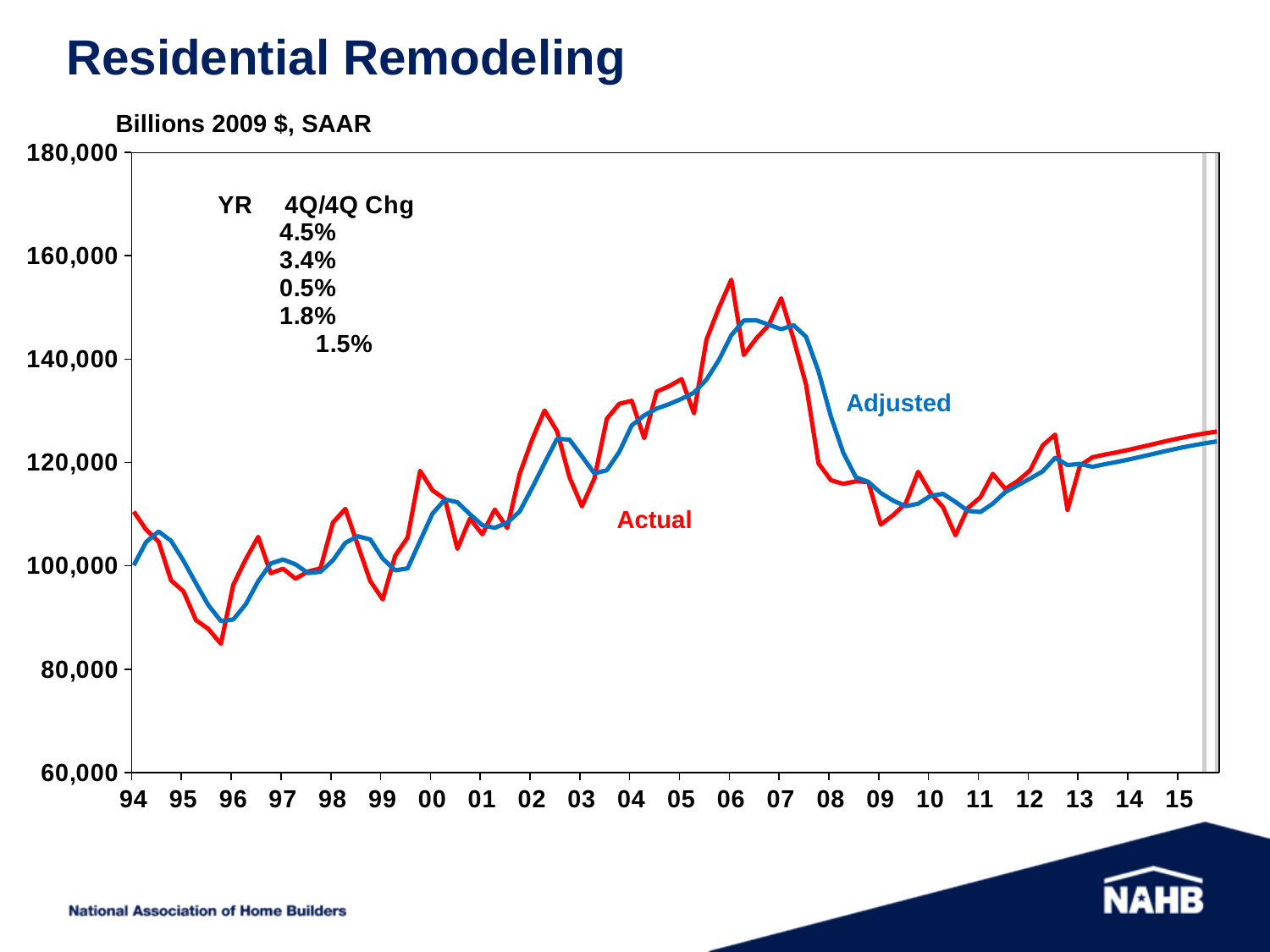
In which year does the Actual series reach its lowest value? 95 At the 06 peak, which series is higher, Actual or Adjusted? Actual Is the Adjusted value at 09 greater or less than 120,000? less Is the lowest value of the Actual series around 96 greater or less than 100,000? less What colour is the Actual line? red How many data series are plotted on the chart? 2 Does the Adjusted series rise or fall between 07 and 09? fall Is the peak value of the Actual series around 06 greater or less than 140,000? greater What kind of chart is shown on the slide? line chart In which year does the Actual series reach its highest value? 06 What unit label is shown above the y axis? Billions 2009 $, SAAR